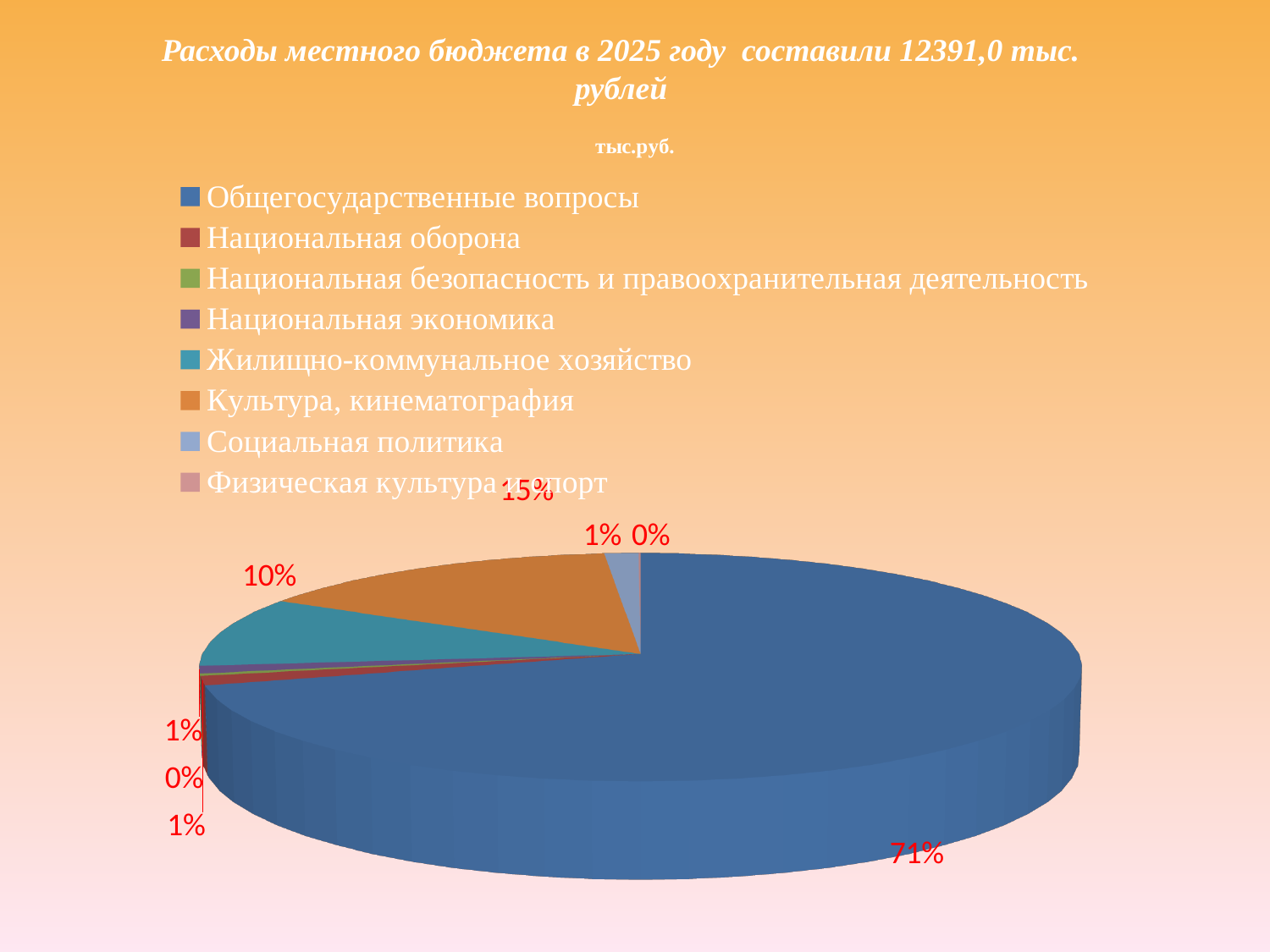
How many categories does the legend of the pie chart list? 8 What is the title printed above the pie chart? тыс.руб. What share of the pie does Физическая культура и спорт take? 0% What share of the pie does Общегосударственные вопросы take? 71% What share of the pie does Культура, кинематография take? 15% According to the slide title, what was the total local budget expenditure in 2025? 12391,0 тыс. рублей Which category has the largest share of the pie chart? Общегосударственные вопросы What kind of chart is shown on the slide? pie chart What is the difference in percentage points between the share for Общегосударственные вопросы and the share for Культура, кинематография? 56 Which is larger: the share for Культура, кинематография or the share for Жилищно-коммунальное хозяйство? Культура, кинематография